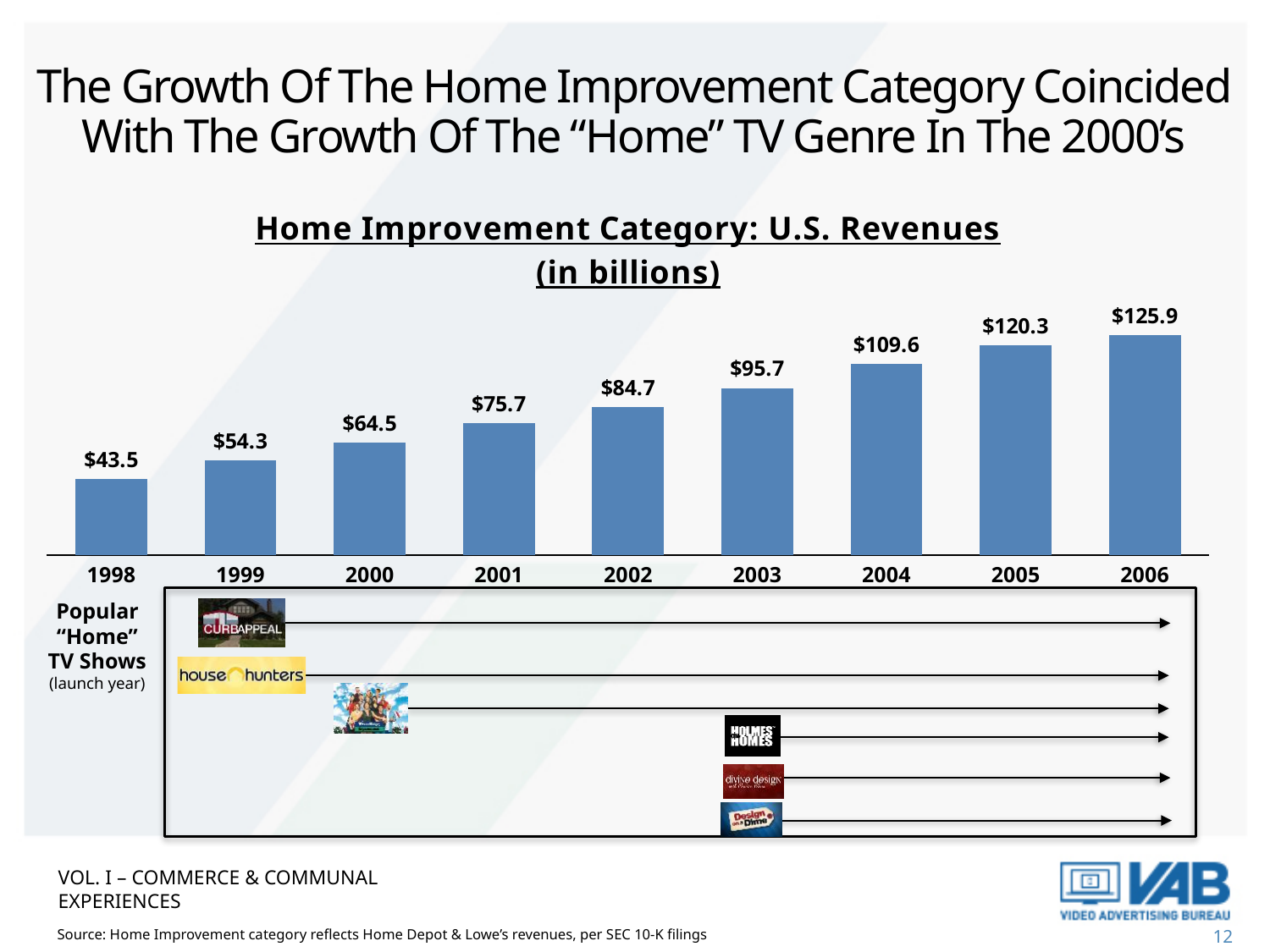
What is the value for 2006? $125.9 What is the value for 2003? $95.7 Do the values rise or fall from 1998 to 2006? rise How many years are shown on the chart? 9 What kind of chart is this? bar chart Which year has the highest value? 2006 What is the title of the chart? Home Improvement Category: U.S. Revenues (in billions) What is the difference between the values for 2005 and 2004? $10.7 Which is larger, the value for 2001 or the value for 2002? 2002 What is the difference between the values for 2006 and 1998? $82.4 What is the value for 1998? $43.5 Which year has the lowest value? 1998